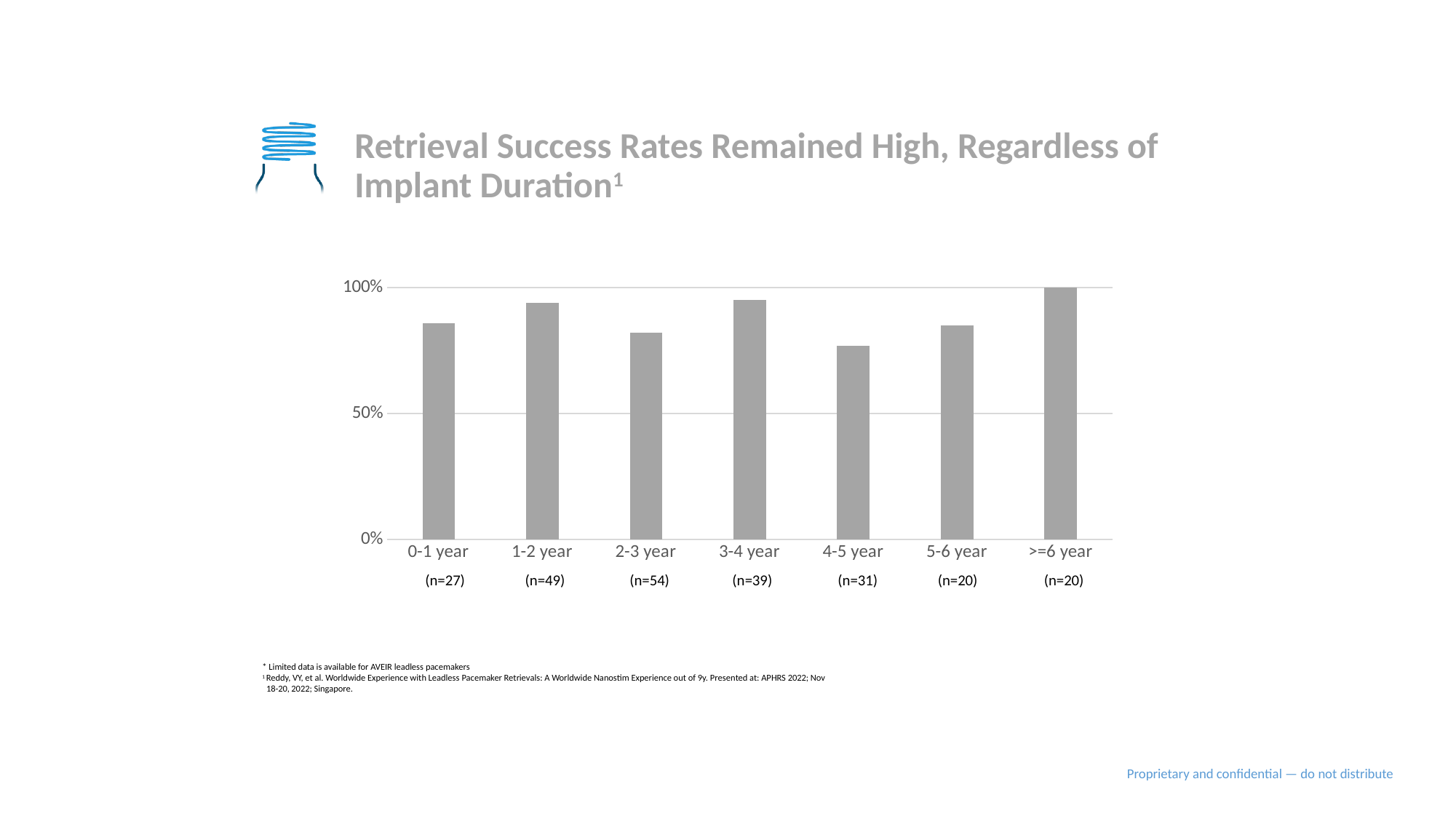
Which has a higher retrieval success rate, the 1-2 year category or the 0-1 year category? 1-2 year Is the retrieval success rate for the 4-5 year category greater or less than 50%? greater Which implant duration category has the highest retrieval success rate? >=6 year Is the retrieval success rate for the 2-3 year category greater or less than 100%? less Which implant duration category has the lowest retrieval success rate? 4-5 year Which has a higher retrieval success rate, the 3-4 year category or the 4-5 year category? 3-4 year What is the sample size (n) shown for the 2-3 year category? n=54 What type of chart is shown on the slide? bar chart Is the retrieval success rate for the 0-1 year category greater or less than 50%? greater What is the title of the chart on the slide? Retrieval Success Rates Remained High, Regardless of Implant Duration What is the retrieval success rate for the >=6 year category? 100% How many implant duration categories are shown on the x axis? 7